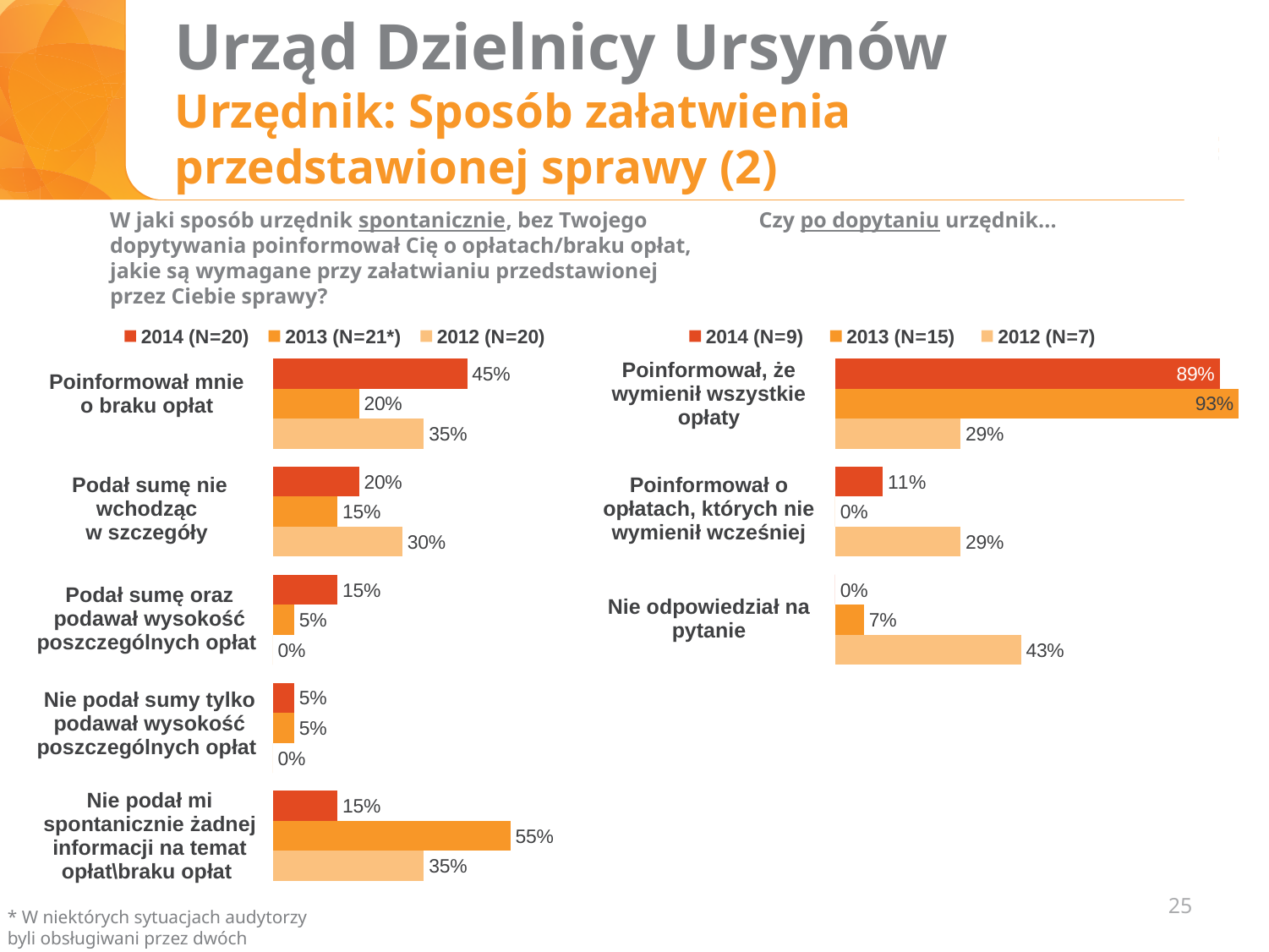
In the left chart (spontaneous information about fees), how many series does the legend list? 3 In the right chart (after asking, "Czy po dopytaniu urzędnik..."), what is the 2013 value for "Poinformował, że wymienił wszystkie opłaty"? 93% In the left chart (spontaneous information about fees), which category has the highest 2013 value? Nie podał mi spontanicznie żadnej informacji na temat opłat\braku opłat In the right chart (after asking, "Czy po dopytaniu urzędnik..."), what is the difference between the 2012 and 2013 values for "Nie odpowiedział na pytanie"? 36 percentage points In the right chart (after asking, "Czy po dopytaniu urzędnik..."), which is larger for "Poinformował, że wymienił wszystkie opłaty": the 2014 value or the 2012 value? 2014 In the left chart (spontaneous information about fees), how many categories are shown? 5 In the left chart (spontaneous information about fees), what is the 2013 value for "Nie podał mi spontanicznie żadnej informacji na temat opłat\braku opłat"? 55% In the right chart (after asking, "Czy po dopytaniu urzędnik..."), what is the 2012 value for "Nie odpowiedział na pytanie"? 43% In the left chart (spontaneous information about fees), what is the difference between the 2014 and 2013 values for "Poinformował mnie o braku opłat"? 25 percentage points In the left chart (spontaneous information about fees), what is the 2014 value for "Poinformował mnie o braku opłat"? 45% In the right chart (after asking, "Czy po dopytaniu urzędnik..."), what sample size does the legend give for 2014? N=9 What type of chart is used on the right side of the slide? Bar chart